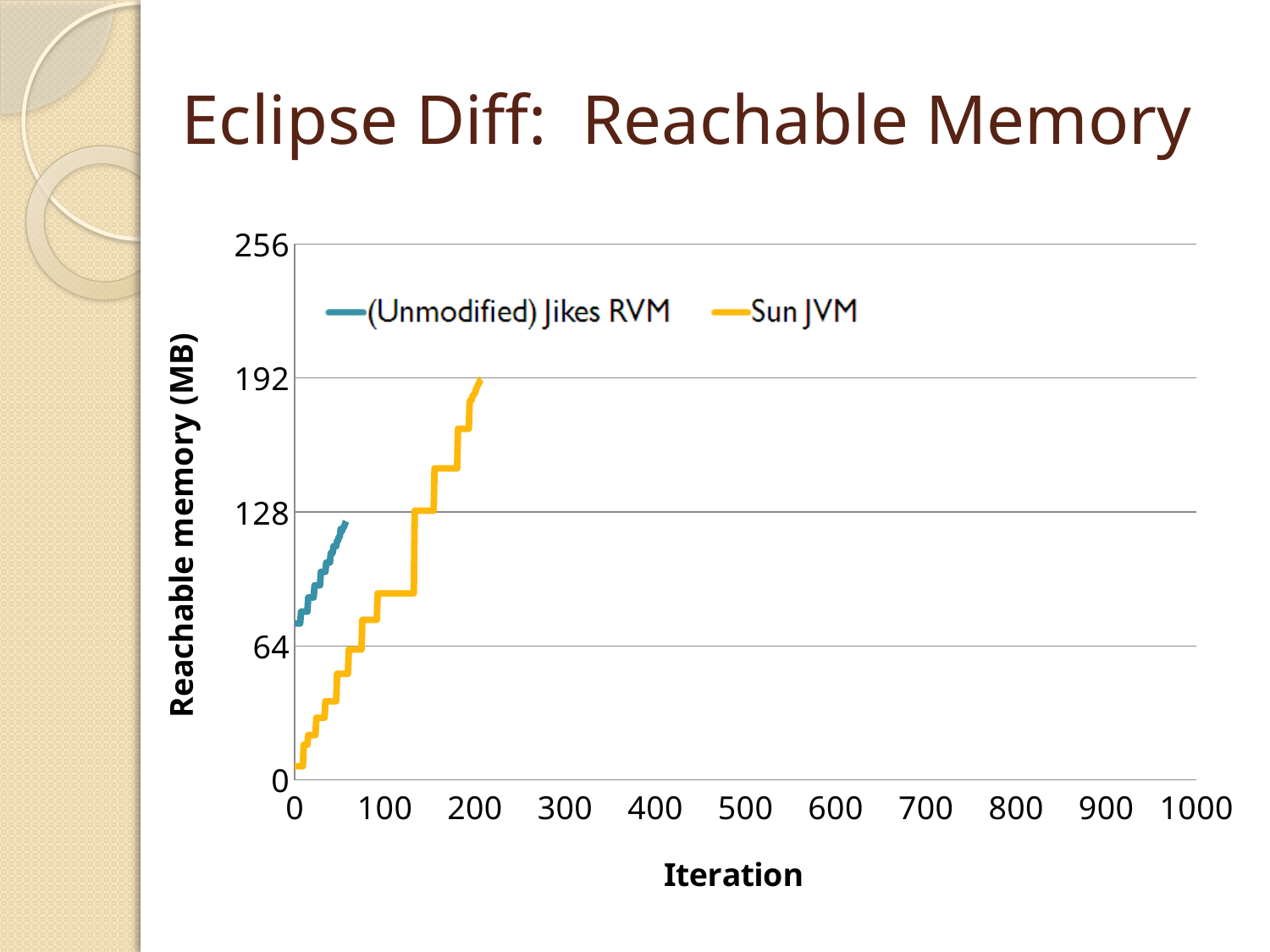
What kind of chart is shown on the slide? line chart Which series reaches the higher reachable memory value on the chart? Sun JVM Does the Sun JVM series rise or fall as the iteration increases? rise Is the Sun JVM value at iteration 100 greater or less than 128? less Is the (Unmodified) Jikes RVM value at iteration 50 greater or less than 64? greater Is the Sun JVM value at iteration 100 greater or less than 64? greater How many series does the legend list? 2 What are the two series named in the legend? (Unmodified) Jikes RVM and Sun JVM At iteration 50, which series has the larger reachable memory, (Unmodified) Jikes RVM or Sun JVM? (Unmodified) Jikes RVM What is the title of the chart? Eclipse Diff: Reachable Memory Does the (Unmodified) Jikes RVM series rise or fall as the iteration increases? rise